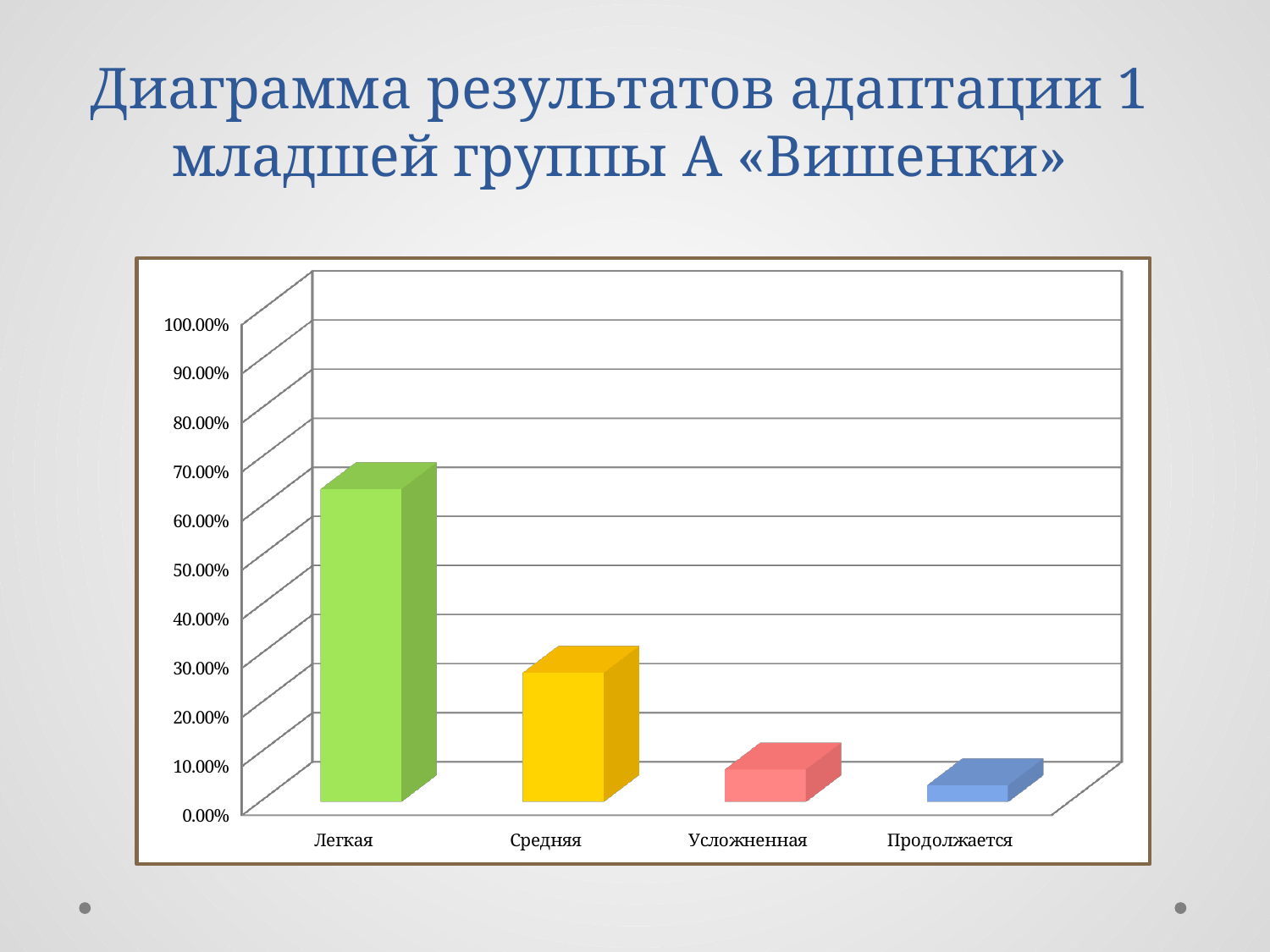
How many categories are shown on the x axis of the chart? 4 Is the value for Усложненная greater or less than 10.00%? less Is the value for Легкая greater or less than 50.00%? greater Which is larger, the value for Средняя or the value for Усложненная? Средняя Which is larger, the value for Легкая or the value for Средняя? Легкая What kind of chart is shown on the slide? bar chart Is the value for Средняя greater or less than 40.00%? less Do the values rise or fall moving from left to right along the x axis? fall Which category has the lowest value in the chart? Продолжается Which category has the highest value in the chart? Легкая What colour is the bar for Легкая? green